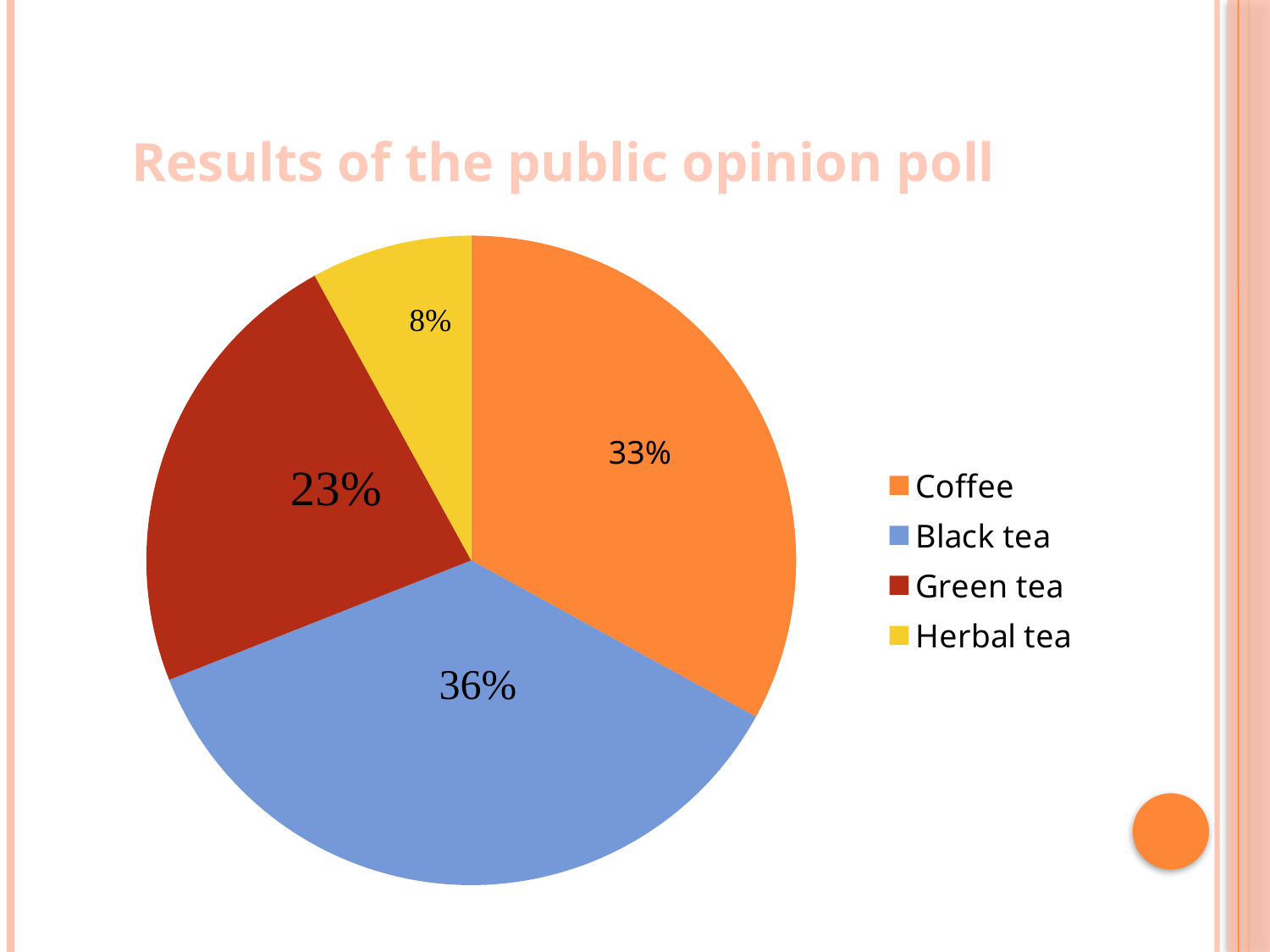
What share of the pie does Black tea have? 36% How many categories are shown in the pie chart? 4 What is the difference in percentage points between Green tea and Herbal tea? 15 Which is larger, the share for Coffee or the share for Green tea? Coffee Which category has the smallest slice of the pie? Herbal tea Which category has the largest slice of the pie? Black tea What kind of chart is shown on the slide? Pie chart What is the difference in percentage points between Black tea and Coffee? 3 What is the title of the slide containing the chart? Results of the public opinion poll What share of the pie does Coffee have? 33% What share of the pie does Green tea have? 23% What share of the pie does Herbal tea have? 8%